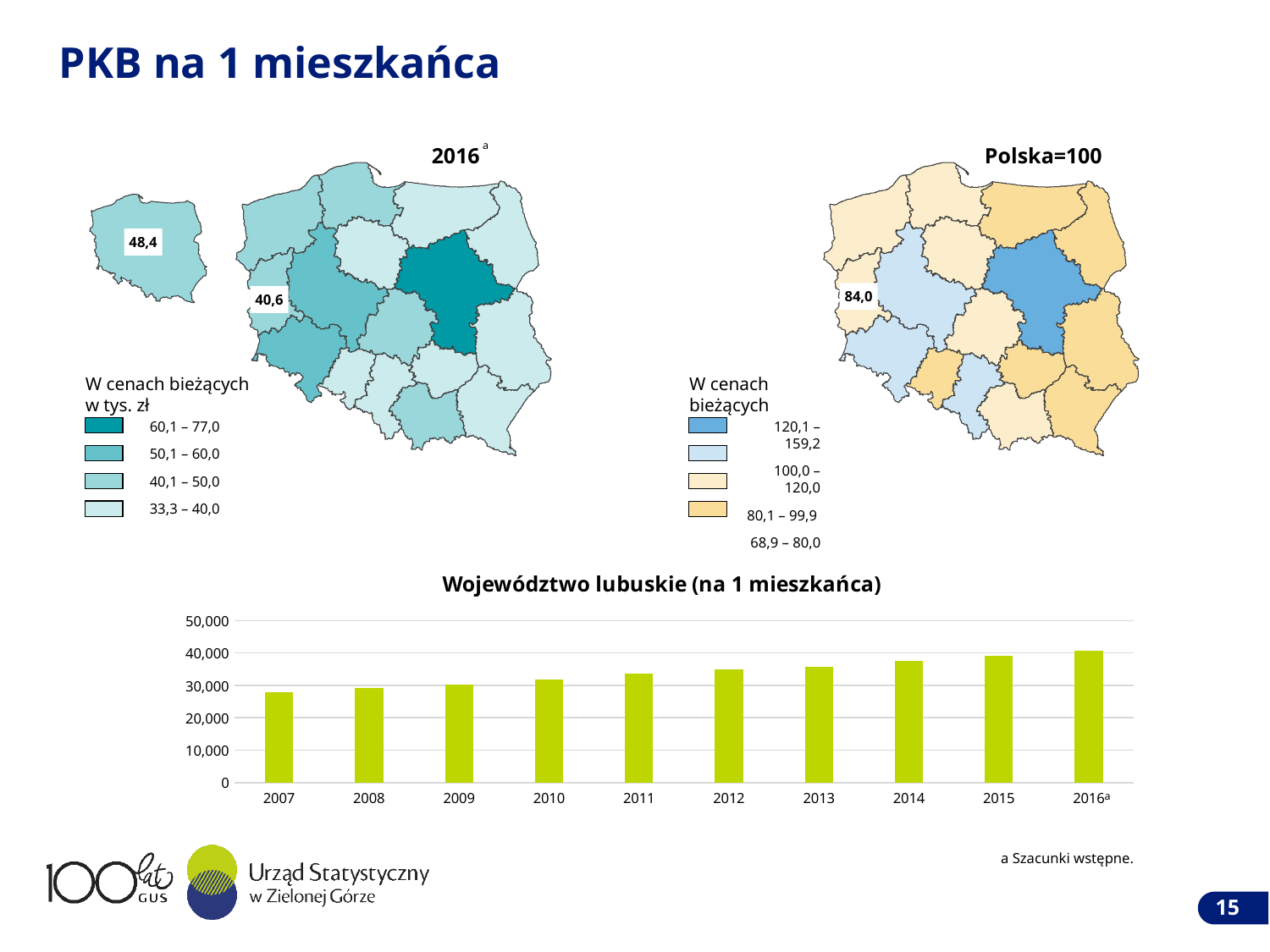
On the right map (Polska=100), what value is printed for the highlighted western voivodeship? 84,0 In the 'Województwo lubuskie (na 1 mieszkańca)' chart, is the value for 2012 greater or less than 30,000? greater In the 'Województwo lubuskie (na 1 mieszkańca)' chart, is the value for 2014 greater or less than 40,000? less In the 'Województwo lubuskie (na 1 mieszkańca)' chart, is the value for 2007 greater or less than 30,000? less On the left map (2016a), what value is printed for the highlighted western voivodeship? 40,6 What is the title of the bar chart at the bottom of the slide? Województwo lubuskie (na 1 mieszkańca) What kind of chart is 'Województwo lubuskie (na 1 mieszkańca)'? bar chart In the 'Województwo lubuskie (na 1 mieszkańca)' chart, which year has the highest bar? 2016a In the 'Województwo lubuskie (na 1 mieszkańca)' chart, do the values rise or fall from 2007 to 2016a? rise In the 'Województwo lubuskie (na 1 mieszkańca)' chart, which year has the lowest bar? 2007 How many years are shown on the x axis of the 'Województwo lubuskie (na 1 mieszkańca)' chart? 10 In the 'Województwo lubuskie (na 1 mieszkańca)' chart, which is larger, the value for 2015 or the value for 2010? 2015